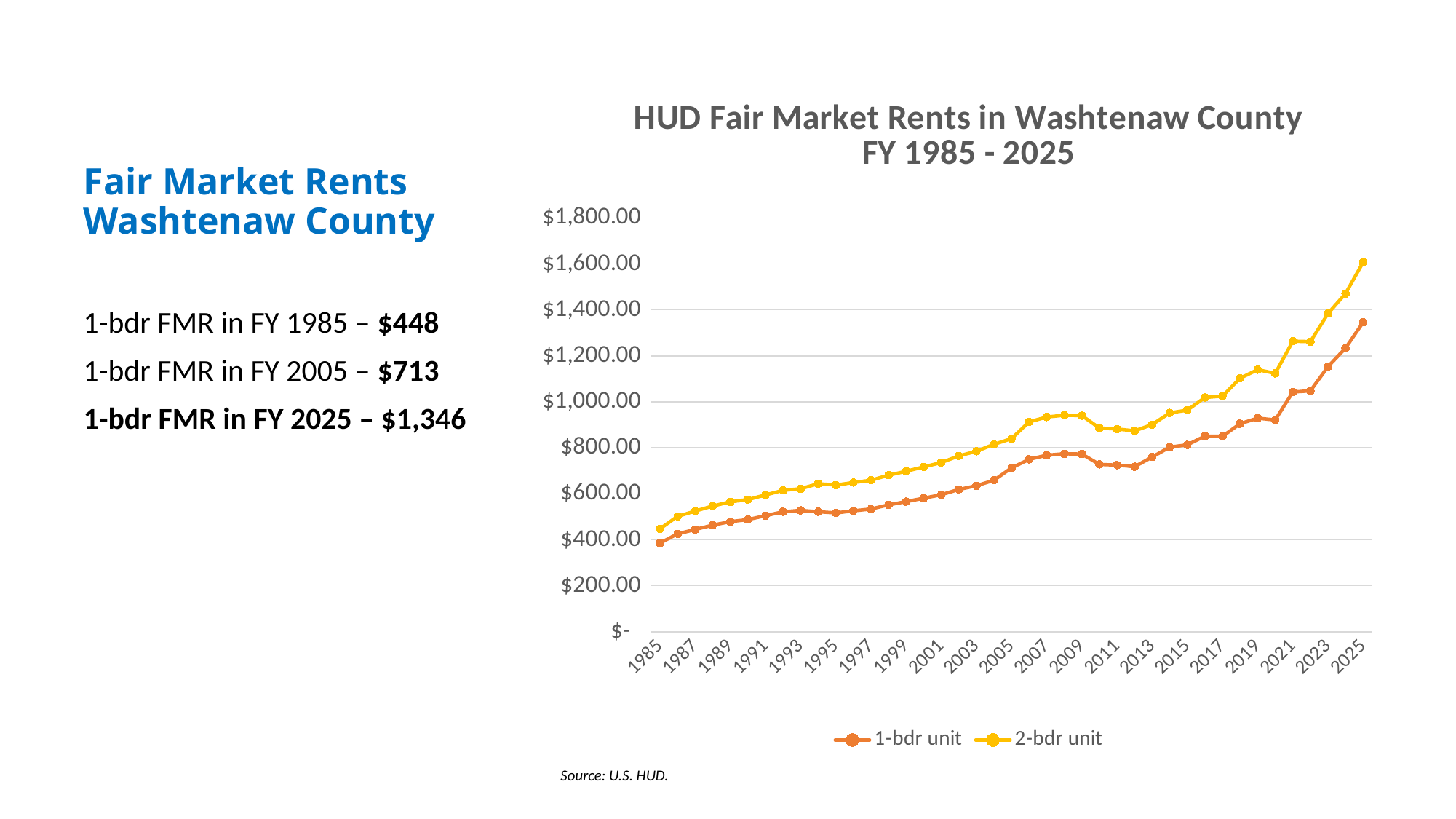
What are the two series named in the chart legend? 1-bdr unit and 2-bdr unit What was the 1-bdr FMR in FY 2025? $1,346 Is the 1-bdr unit value for 2009 greater or less than $800.00? less How many series does the chart legend list? 2 What type of chart is shown on the slide? line chart By how much did the 1-bdr FMR increase from FY 1985 to FY 2025? $898 What was the 1-bdr FMR in FY 2005? $713 Overall, do the fair market rents rise or fall from 1985 to 2025? rise Is the 2-bdr unit value for 2023 greater or less than $1,200.00? greater What is the title of the chart? HUD Fair Market Rents in Washtenaw County FY 1985 - 2025 What was the 1-bdr FMR in FY 1985? $448 Which series has the higher value in 2025, 1-bdr unit or 2-bdr unit? 2-bdr unit